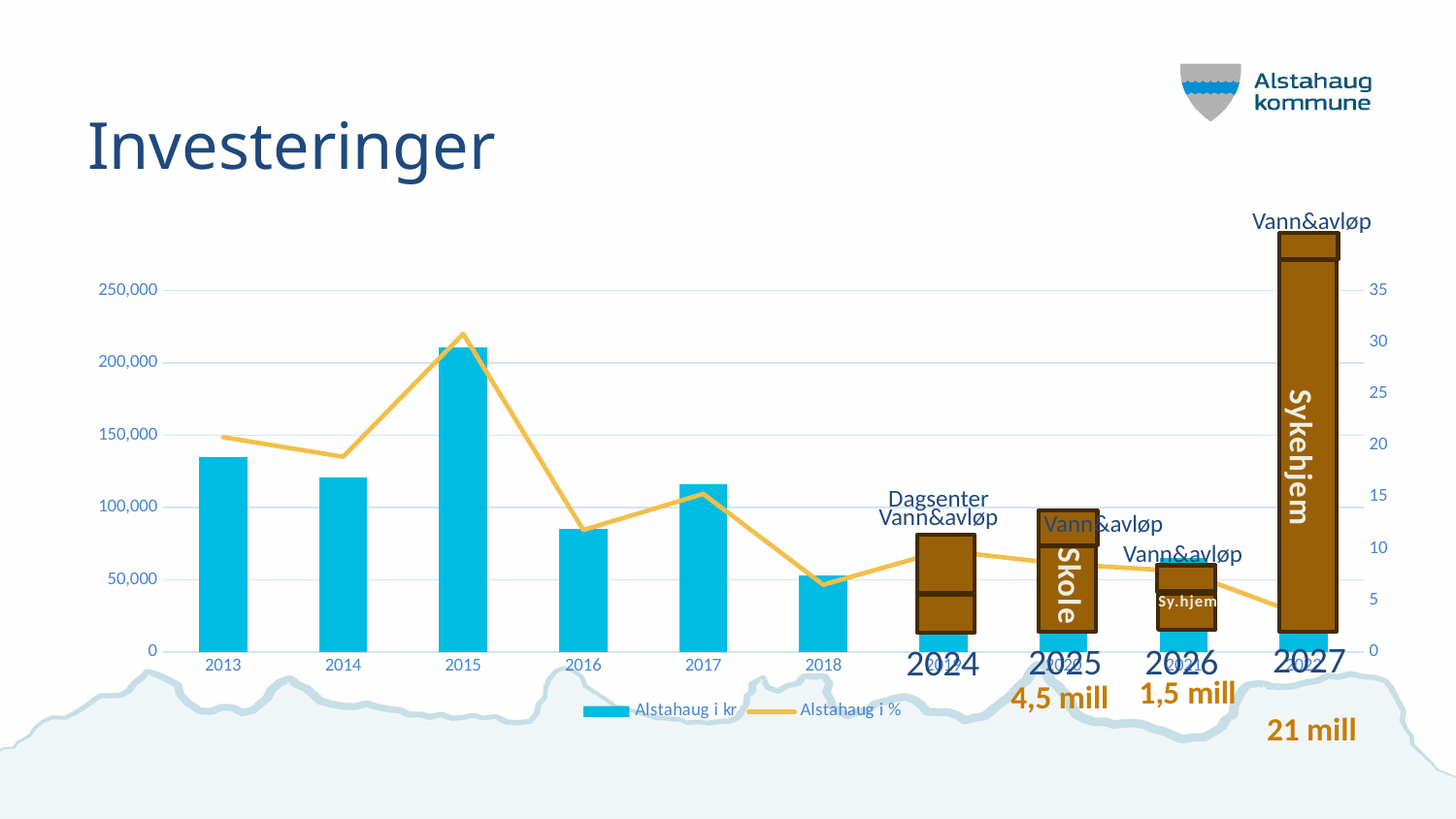
Among the years 2013 to 2018, which year has the highest bar for Alstahaug i kr? 2015 Is the Alstahaug i kr bar for 2016 greater or less than 100,000? less Do the Alstahaug i kr bars rise or fall from 2015 to 2018? fall Is the Alstahaug i kr bar for 2013 greater or less than 100,000? greater What kind of chart is shown on the slide? A combined bar and line chart How many series does the chart legend list? 2 Is the Alstahaug i kr bar for 2018 greater or less than 100,000? less Among the years 2013 to 2018, which year has the lowest bar for Alstahaug i kr? 2018 What is the title of the slide containing the chart? Investeringer Which year has the larger Alstahaug i kr bar, 2013 or 2014? 2013 What are the two series named in the chart legend? Alstahaug i kr and Alstahaug i %